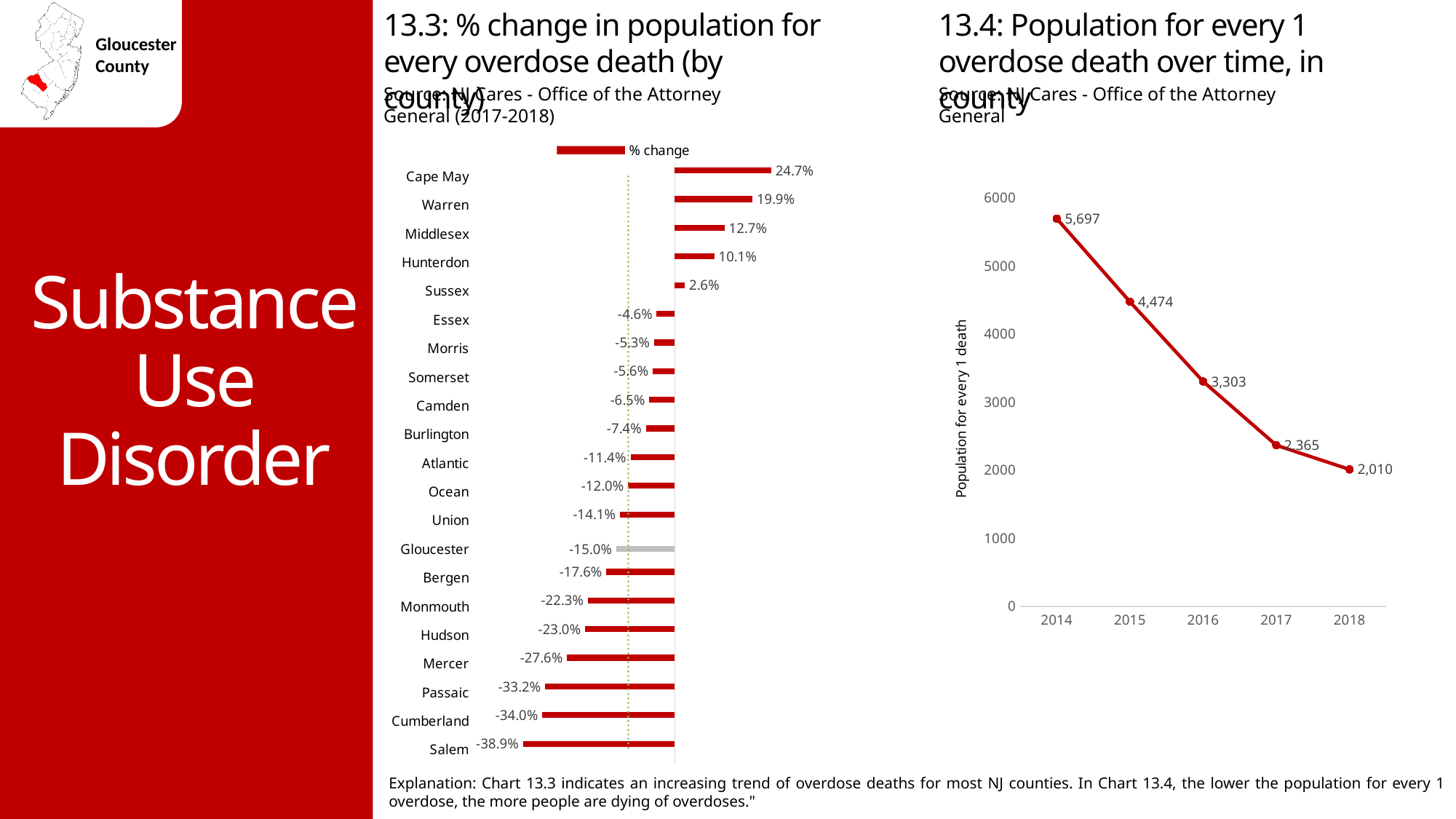
In chart 13.4, what is the difference between the 2014 and 2015 values? 1,223 In chart 13.3, what is the % change for Cape May? 24.7% In chart 13.3, what is the % change for Gloucester? -15.0% In chart 13.3, what is the difference between the % change for Warren and Middlesex? 7.2 percentage points In chart 13.3, which county has the lowest % change? Salem In chart 13.3, which county has the highest % change? Cape May What kind of chart is chart 13.4? line chart In chart 13.4, do the values rise or fall from 2014 to 2018? fall In chart 13.4, what is the population for every 1 overdose death in 2018? 2,010 In chart 13.3, how many counties are plotted? 21 In chart 13.3, which has a larger % change, Hudson or Mercer? Hudson In chart 13.4, what is the population for every 1 overdose death in 2016? 3,303